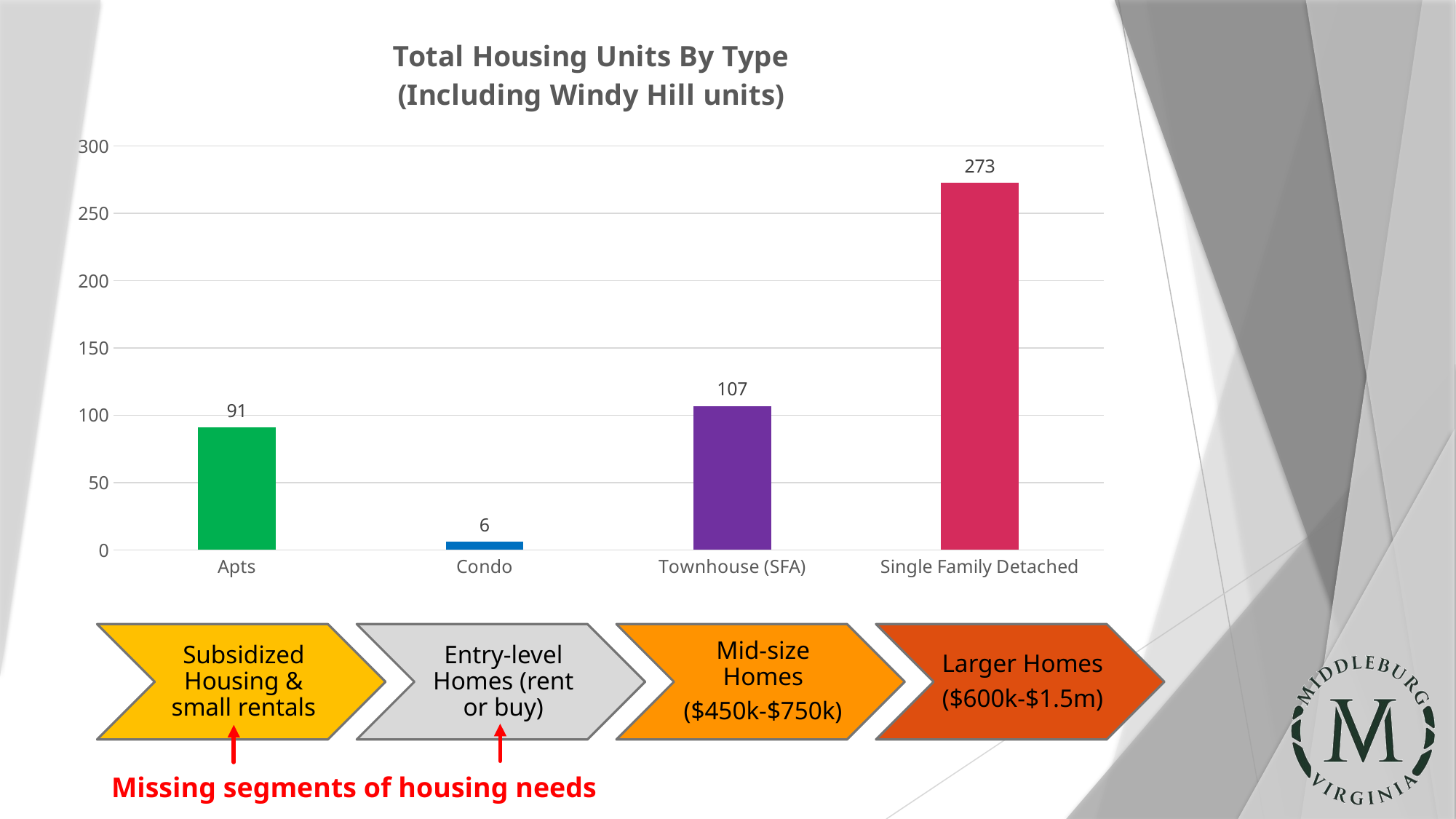
What kind of chart is shown on the slide? bar chart How many housing type categories are shown in the chart? 4 What is the value for Townhouse (SFA)? 107 Is the value for Single Family Detached greater or less than 250? greater What is the value for Condo? 6 What is the value for Apts? 91 What is the title of the chart? Total Housing Units By Type (Including Windy Hill units) Which housing type has the lowest number of units? Condo Which housing type has the highest number of units? Single Family Detached Which is larger, the value for Apts or the value for Townhouse (SFA)? Townhouse (SFA) What is the difference between the values for Single Family Detached and Townhouse (SFA)? 166 What is the value for Single Family Detached? 273